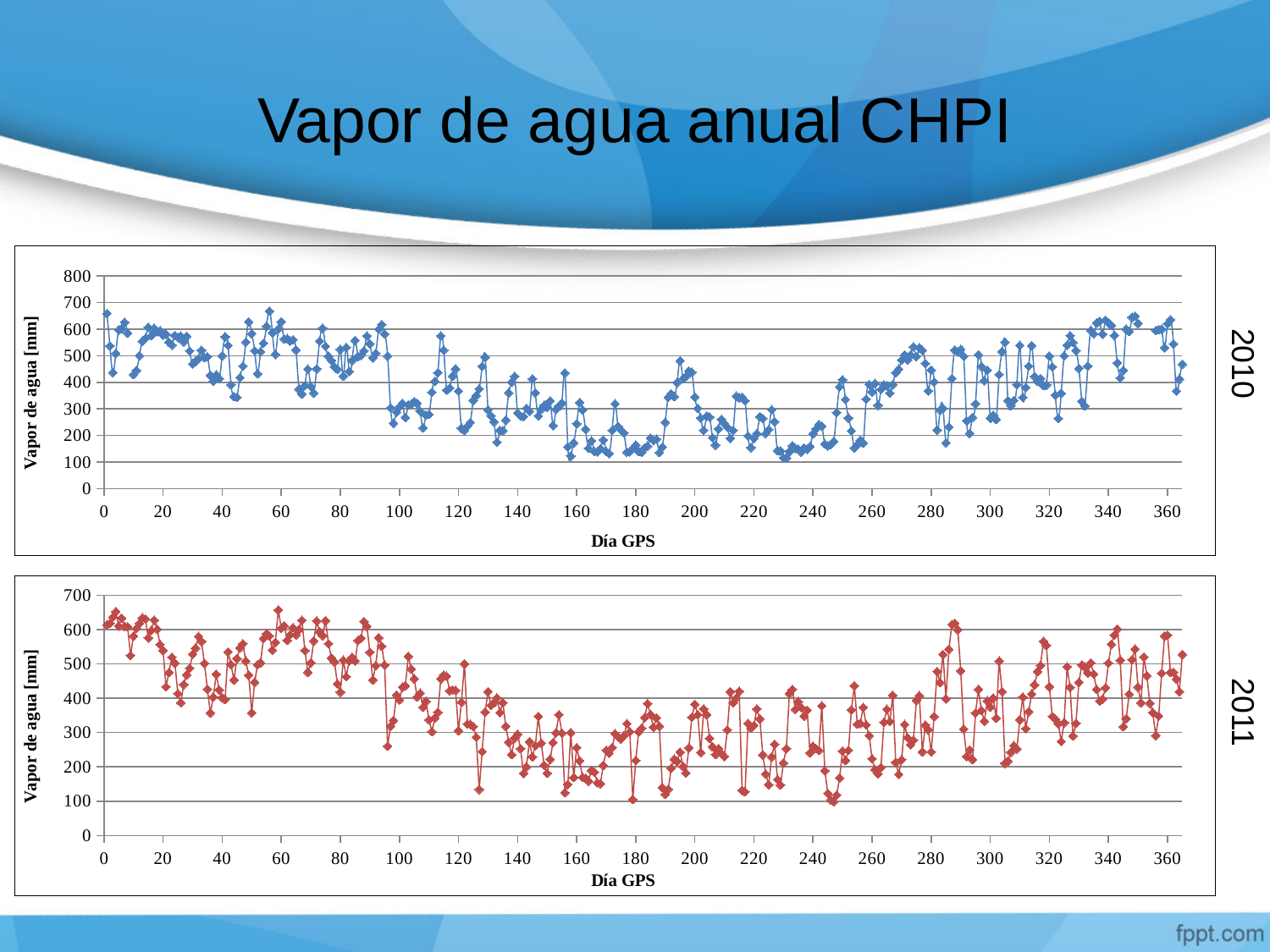
What kind of chart is the top chart (2010)? line chart In the bottom chart (2011), do the values generally rise or fall between day 240 and day 360? rise In the top chart (2010), is the value around day 230 greater or less than 300? less In the top chart (2010), is the value around day 170 greater or less than 200? less What is the y-axis title of the bottom chart (2011)? Vapor de agua [mm] What is the highest tick shown on the y-axis of the top chart (2010)? 800 In the top chart (2010), do the values generally rise or fall between day 100 and day 180? fall What is the x-axis title of the top chart (2010)? Día GPS In the top chart (2010), is the value at the first day (near day 0) greater or less than 600? greater